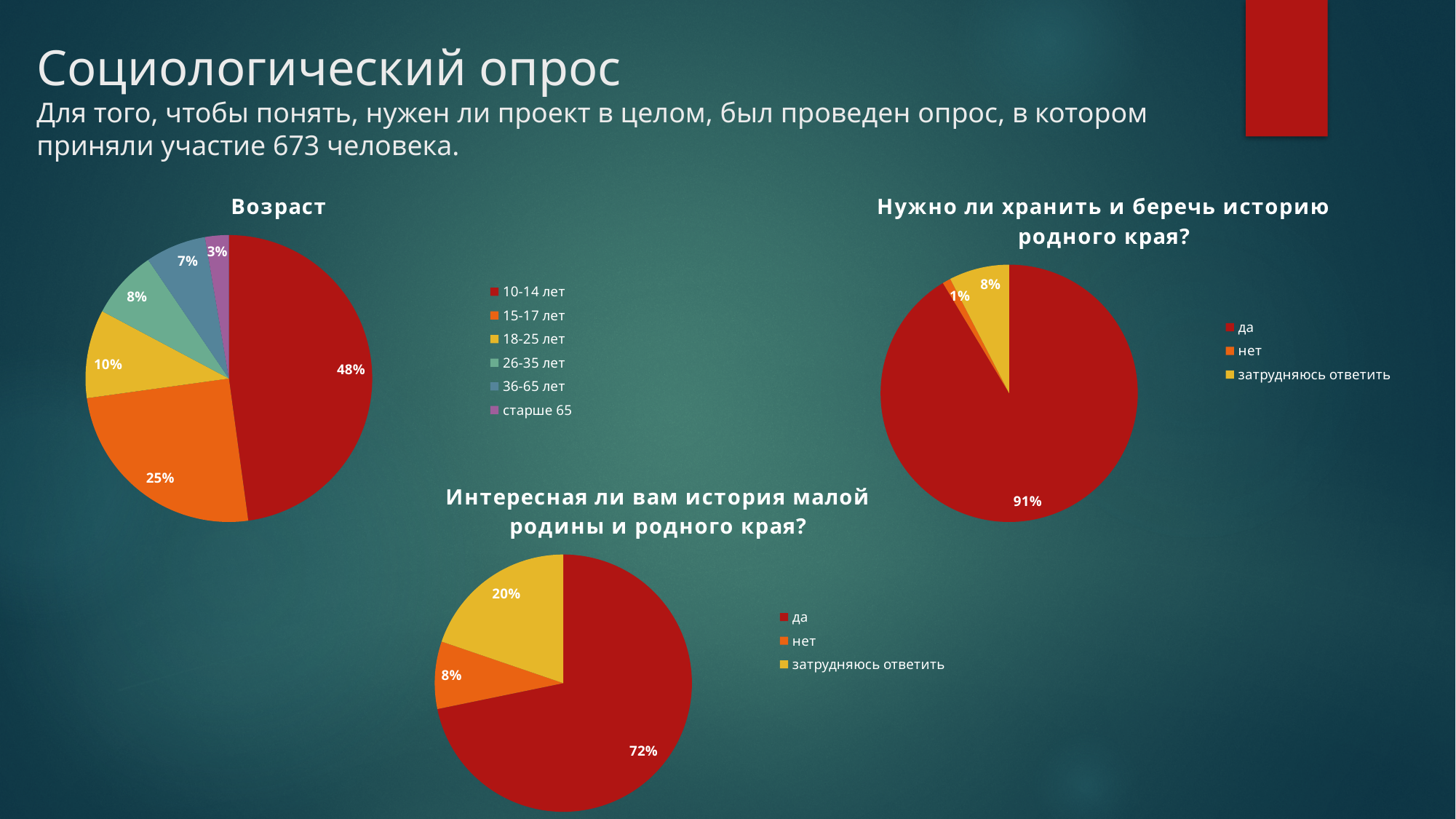
In the 'Возраст' chart, what share of respondents are aged 10-14 лет? 48% What kind of chart is the 'Возраст' chart? Pie chart In the 'Интересная ли вам история малой родины и родного края?' chart, what colour is the 'да' slice? Red In the 'Нужно ли хранить и беречь историю родного края?' chart, what share answered 'нет'? 1% In the 'Возраст' chart, which age group has the smallest share? старше 65 In the 'Возраст' chart, what share of respondents are aged 15-17 лет? 25% In the 'Нужно ли хранить и беречь историю родного края?' chart, what share answered 'да'? 91% In the 'Интересная ли вам история малой родины и родного края?' chart, what is the difference between the shares for 'да' and 'нет'? 64% In the 'Интересная ли вам история малой родины и родного края?' chart, what share answered 'затрудняюсь ответить'? 20% In the 'Возраст' chart, which is larger: the share for 18-25 лет or for 36-65 лет? 18-25 лет In the 'Возраст' chart, how many age categories does the legend list? 6 In the 'Возраст' chart, what is the difference between the shares for 10-14 лет and 15-17 лет? 23%